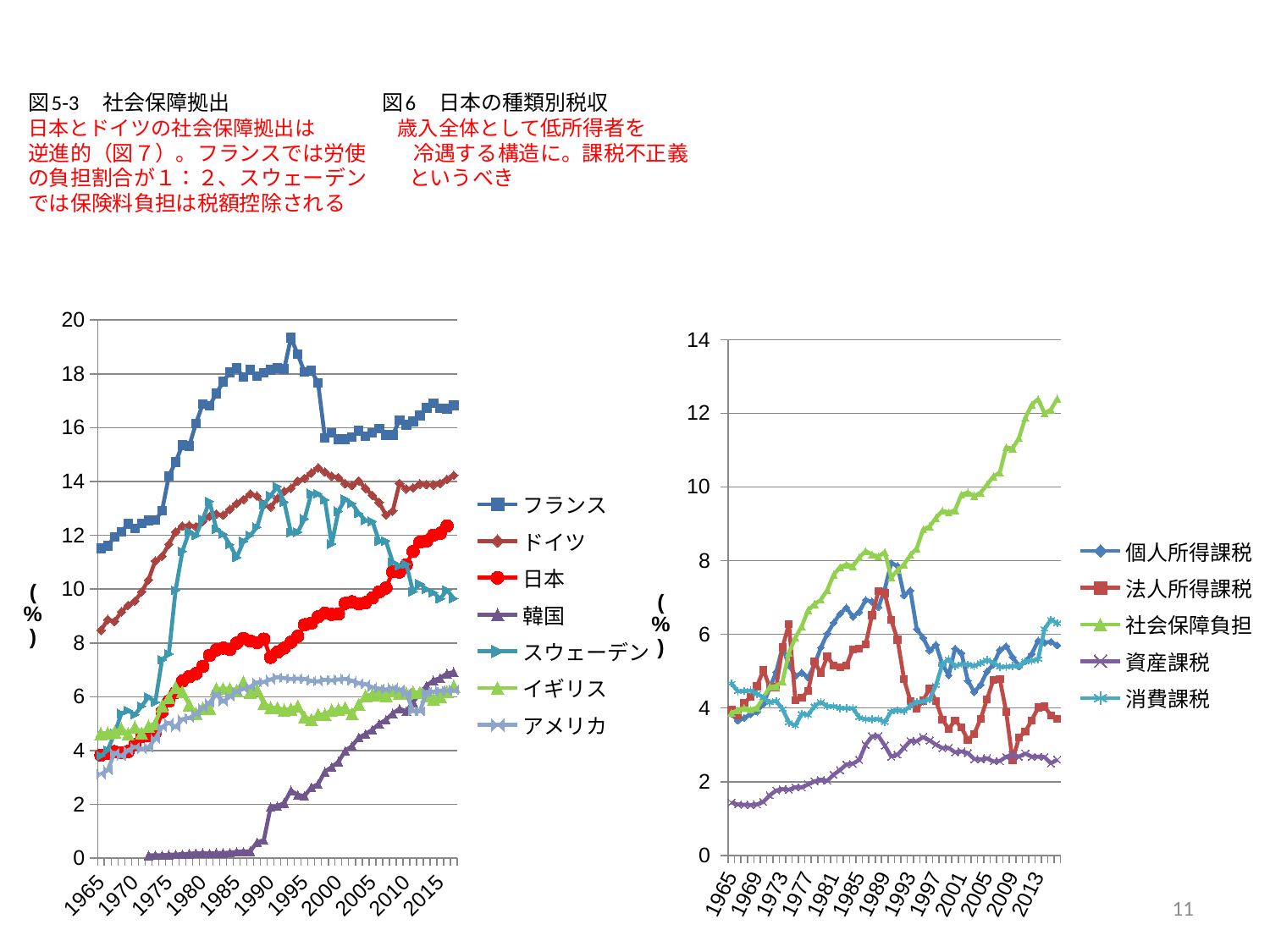
In the left chart (図5-3 社会保障拠出), which series has the highest value at the right end of the x axis (around 2015)? フランス In the right chart (図6 日本の種類別税収), around 2013, which is larger: 消費課税 or 法人所得課税? 消費課税 In the left chart (図5-3 社会保障拠出), is the value for 日本 around 2015 greater or less than 10? greater What kind of chart is the left chart (図5-3 社会保障拠出)? line chart In the right chart (図6 日本の種類別税収), is the value for 社会保障負担 around 2013 greater or less than 10? greater How many series does the legend of the left chart (図5-3 社会保障拠出) list? 7 In the right chart (図6 日本の種類別税収), which series has the lowest value around 2013? 資産課税 In the right chart (図6 日本の種類別税収), which series has the highest value at the right end of the x axis (around 2013)? 社会保障負担 In the left chart (図5-3 社会保障拠出), which series has the lowest value around 1980? 韓国 In the left chart (図5-3 社会保障拠出), around 2015, which is larger: 日本 or スウェーデン? 日本 How many series does the legend of the right chart (図6 日本の種類別税収) list? 5 In the left chart (図5-3 社会保障拠出), does the 韓国 series rise or fall from 1965 to 2015? rise